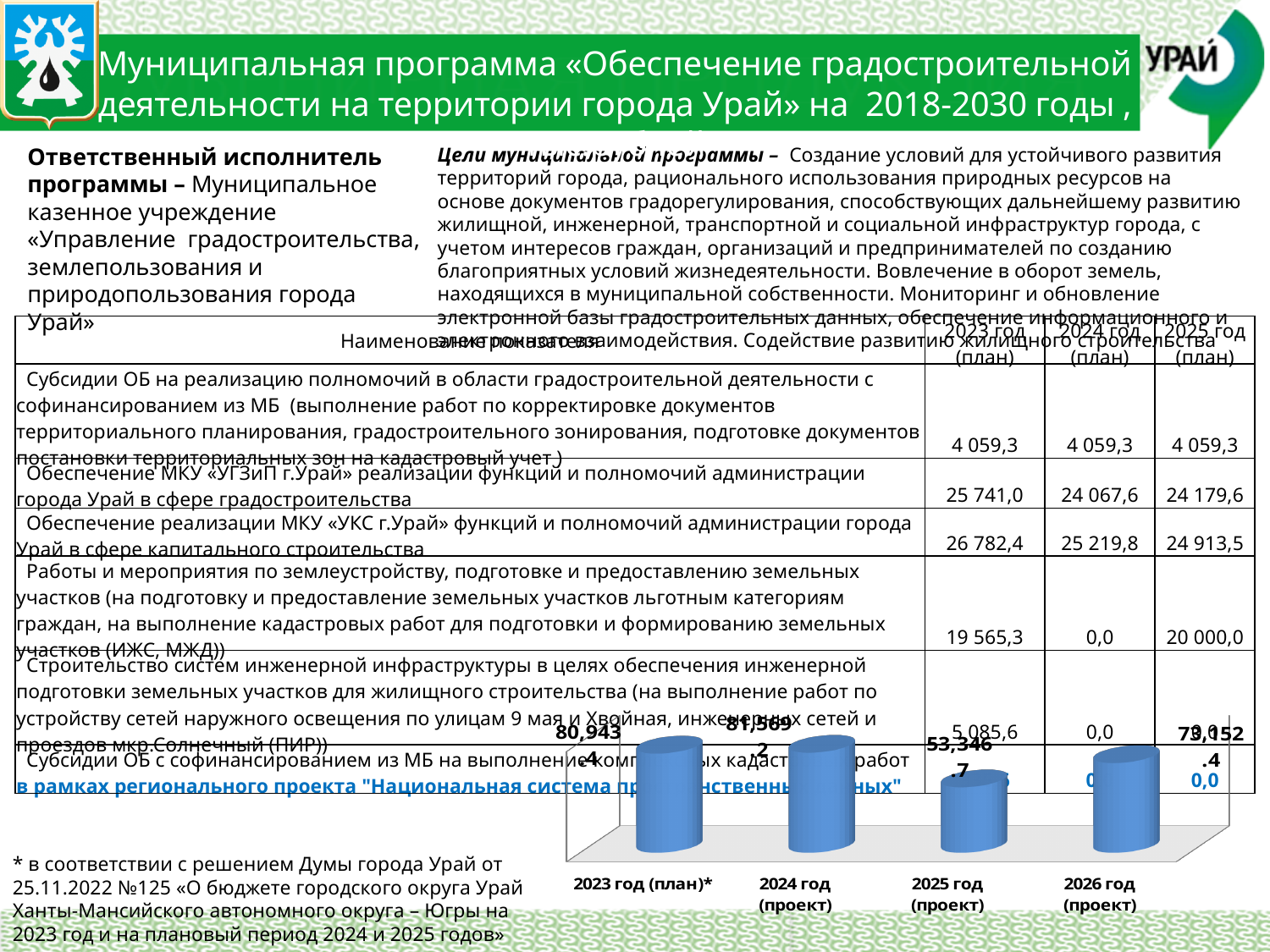
What is the value shown for 2024 год (проект) in the bar chart? 81,569.2 Do the values in the bar chart rise or fall from 2024 год (проект) to 2025 год (проект)? fall Which is larger in the bar chart, the value for 2025 год (проект) or 2026 год (проект)? 2026 год (проект) Which year has the lowest value in the bar chart? 2025 год (проект) What is the difference between the values for 2023 год (план)* and 2025 год (проект) in the bar chart? 27,596.7 How many categories (years) are plotted in the bar chart? 4 What is the value shown for 2023 год (план)* in the bar chart? 80,943.4 What kind of chart is shown at the bottom of the slide? bar chart What is the difference between the values for 2024 год (проект) and 2025 год (проект) in the bar chart? 28,222.5 What is the value shown for 2025 год (проект) in the bar chart? 53,346.7 What is the label of the first category on the x axis of the bar chart? 2023 год (план)* Which is larger in the bar chart, the value for 2024 год (проект) or 2025 год (проект)? 2024 год (проект)